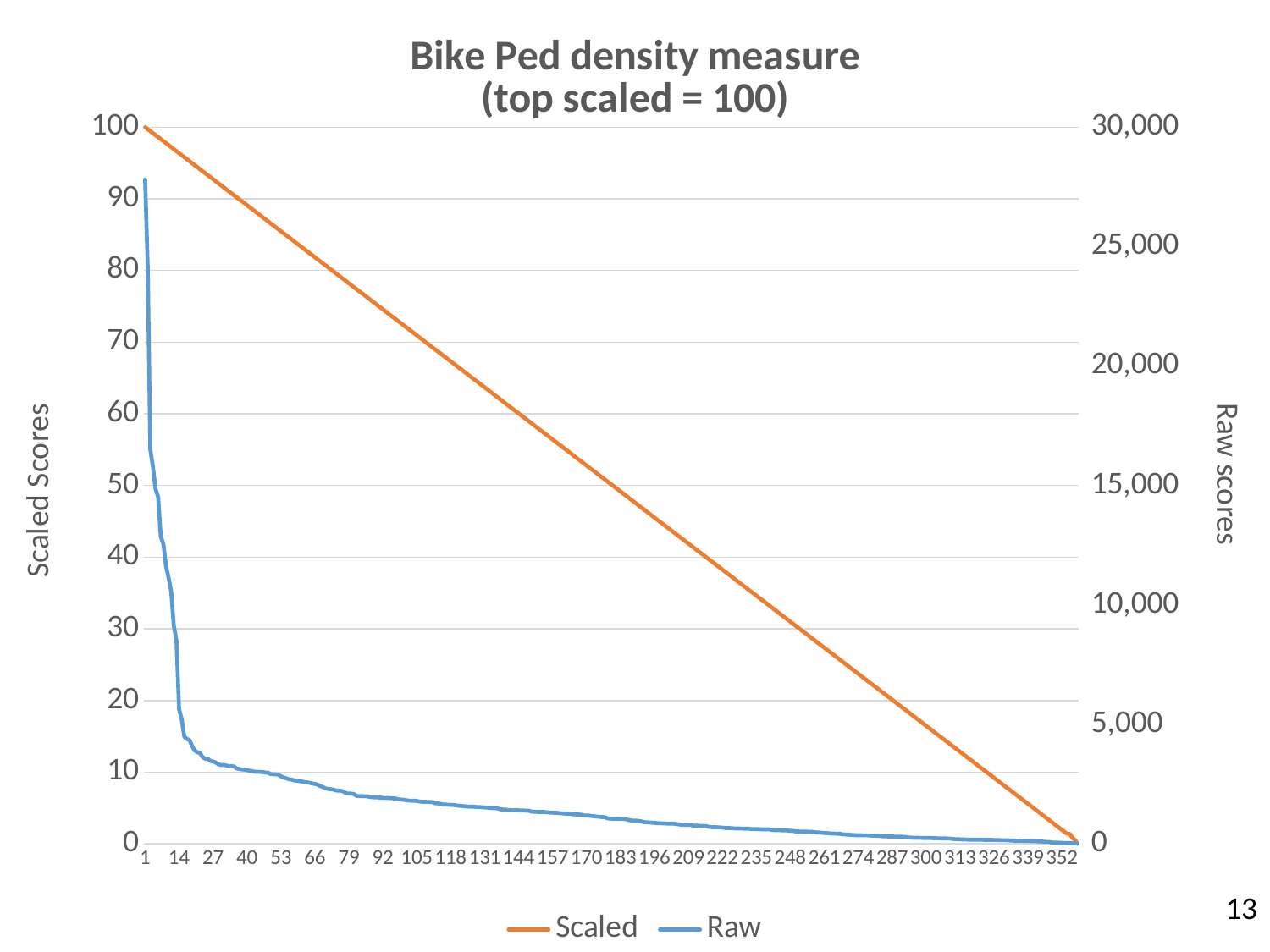
What is the Scaled value at the last point on the x axis? 0 Do the Scaled values rise or fall along the x axis? fall Is the Scaled value at x = 92 greater or less than 70? greater What is the label of the right-hand vertical axis? Raw scores Is the Raw value at x = 183 greater or less than 5,000? less What is the title of the chart? Bike Ped density measure (top scaled = 100) Is the Raw value at x = 1 greater or less than 25,000? greater What is the Scaled value at x = 1? 100 How many series does the legend list? 2 Do the Raw values rise or fall along the x axis? fall What kind of chart is shown on the slide? line chart